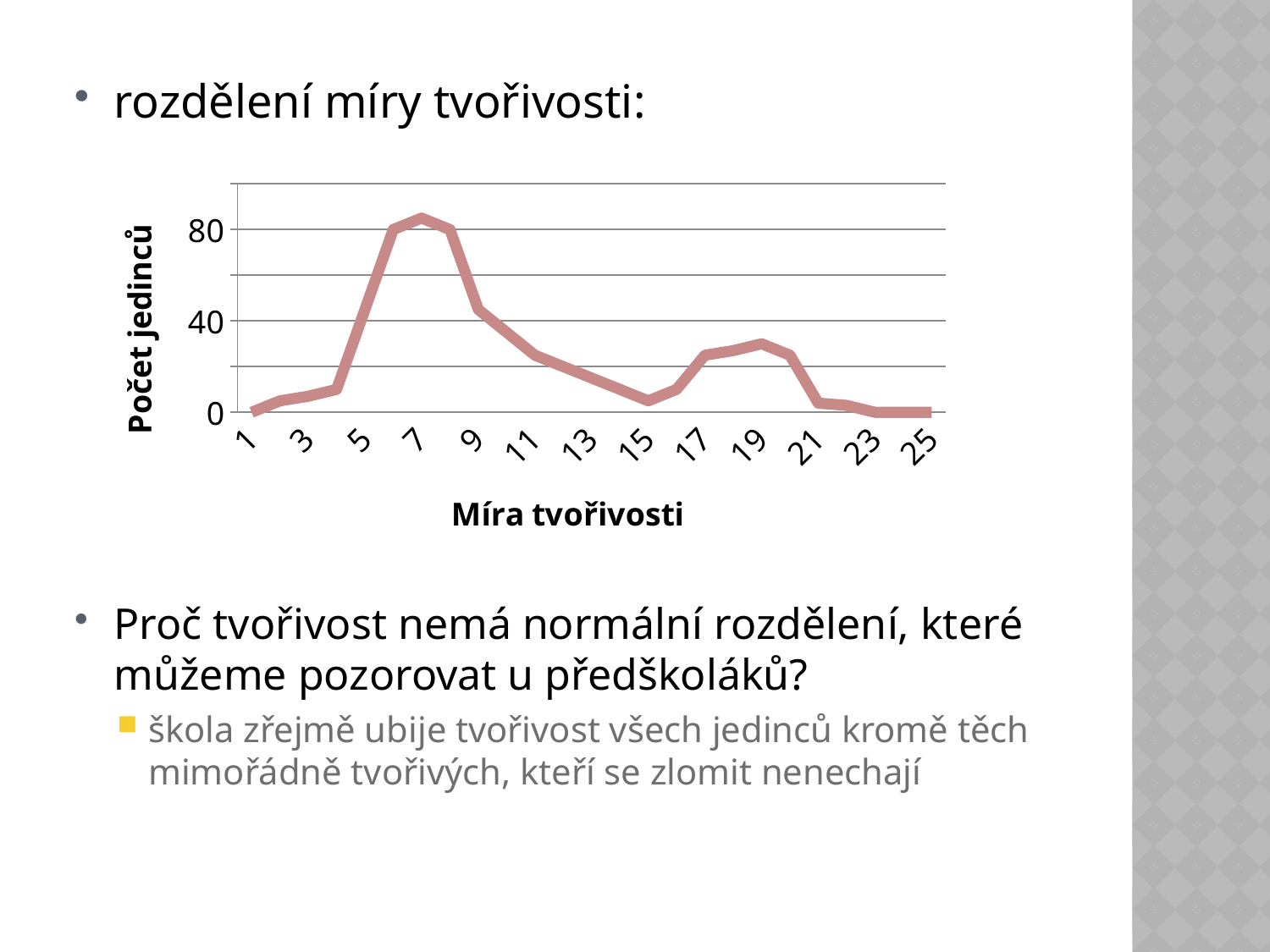
Is the value for Míra tvořivosti 1 greater or less than 40? less How many tick labels are shown on the x axis? 13 Is the value for Míra tvořivosti 7 greater or less than 80? greater Which has the larger value, Míra tvořivosti 7 or Míra tvořivosti 19? 7 Is the value for Míra tvořivosti 19 greater or less than 40? less What is the title of the y axis of the chart? Počet jedinců Between Míra tvořivosti 7 and 15, does the line rise or fall? fall What is the title of the x axis of the chart? Míra tvořivosti What kind of chart is shown on the slide? line chart Which has the larger value, Míra tvořivosti 19 or Míra tvořivosti 15? 19 At which value of Míra tvořivosti does the line reach its highest point? 7